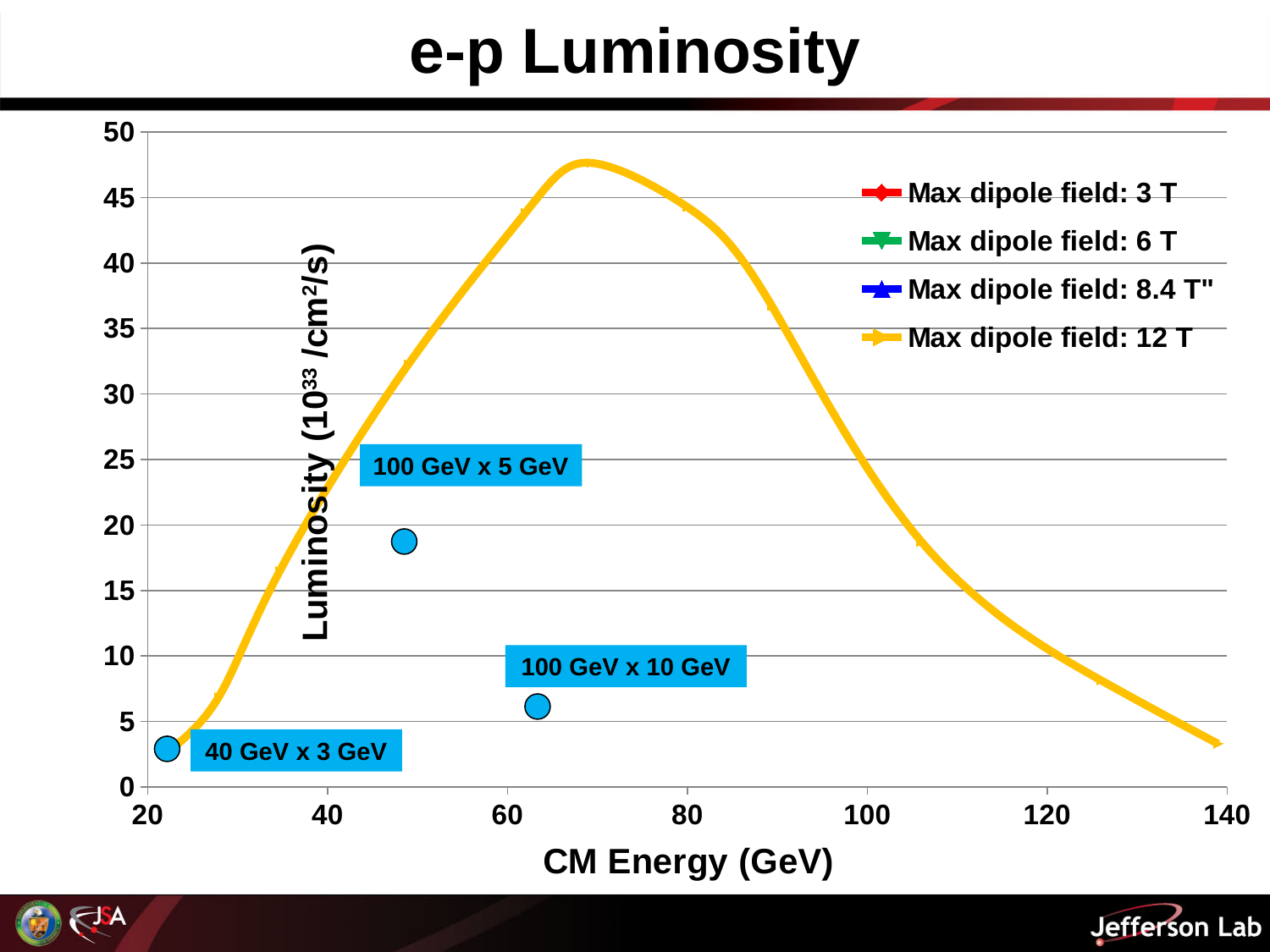
How many series does the legend list? 4 What kind of chart is shown on the slide? line chart Is the value of the 'Max dipole field: 12 T' curve at a CM energy of 80 GeV greater or less than 40? greater What is the title of the chart? e-p Luminosity What is the x-axis title of the chart? CM Energy (GeV) How many labelled blue data points are marked on the chart? 3 Which labelled blue point has the highest luminosity: '40 GeV x 3 GeV', '100 GeV x 5 GeV' or '100 GeV x 10 GeV'? 100 GeV x 5 GeV Is the value of the 'Max dipole field: 12 T' curve at a CM energy of 140 GeV greater or less than 5? less Does the 'Max dipole field: 12 T' curve rise or fall as CM energy increases from 20 GeV to 60 GeV? rise Does the 'Max dipole field: 12 T' curve rise or fall as CM energy increases from 100 GeV to 140 GeV? fall Is the luminosity of the '40 GeV x 3 GeV' point greater or less than 5? less